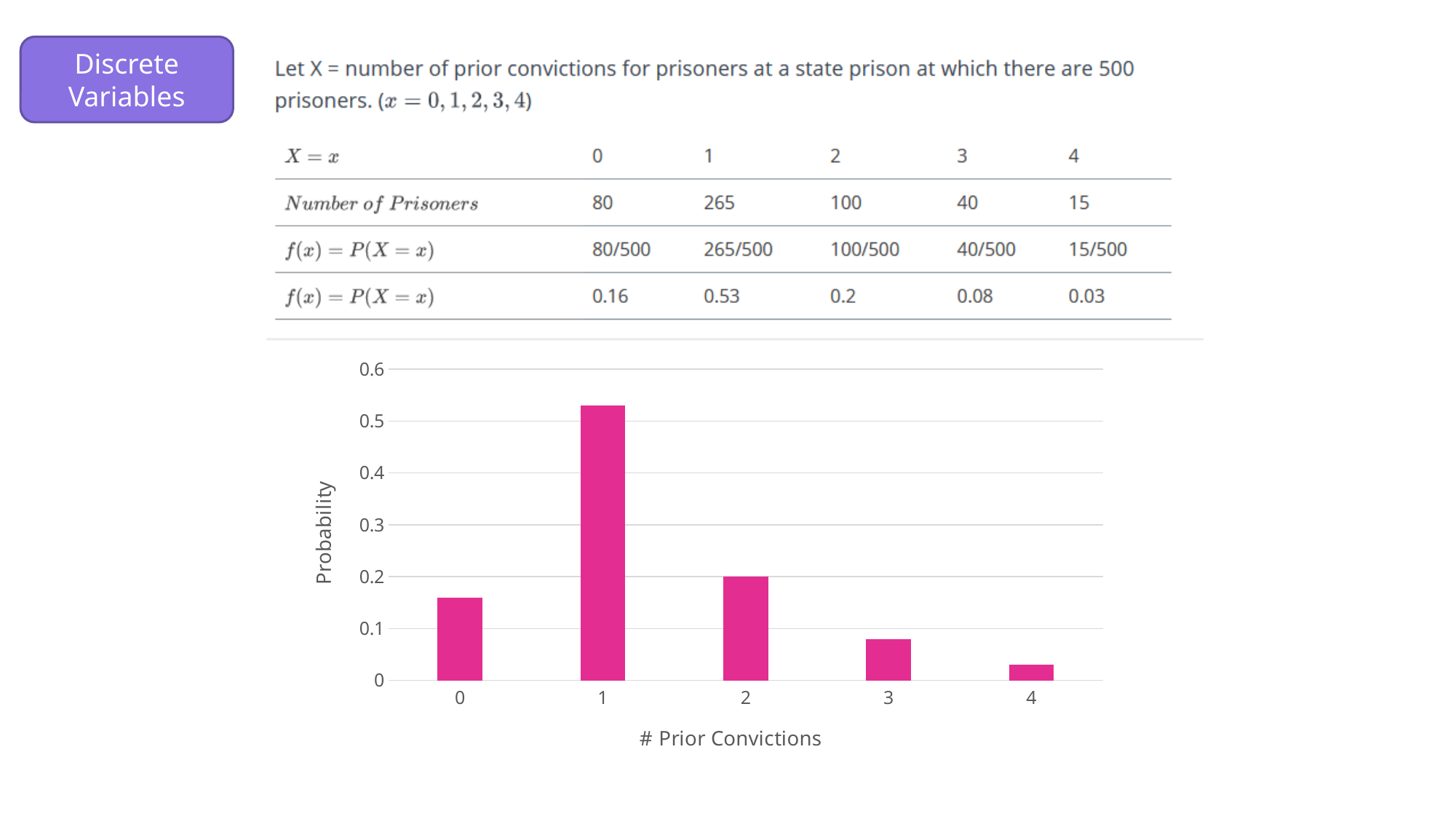
What is the probability for 1 prior conviction? 0.53 Which number of prior convictions has the highest probability? 1 What is the probability for 2 prior convictions? 0.2 What is the probability for 0 prior convictions? 0.16 How many bars (categories) does the chart show? 5 Is the probability for 1 prior conviction greater or less than 0.5? greater Which has a higher probability: 0 prior convictions or 2 prior convictions? 2 prior convictions Is the probability for 3 prior convictions greater or less than 0.1? less What is the label of the x axis? # Prior Convictions Which number of prior convictions has the lowest probability? 4 What is the difference between the probability for 1 prior conviction and the probability for 2 prior convictions? 0.33 What kind of chart is shown on the slide? bar chart